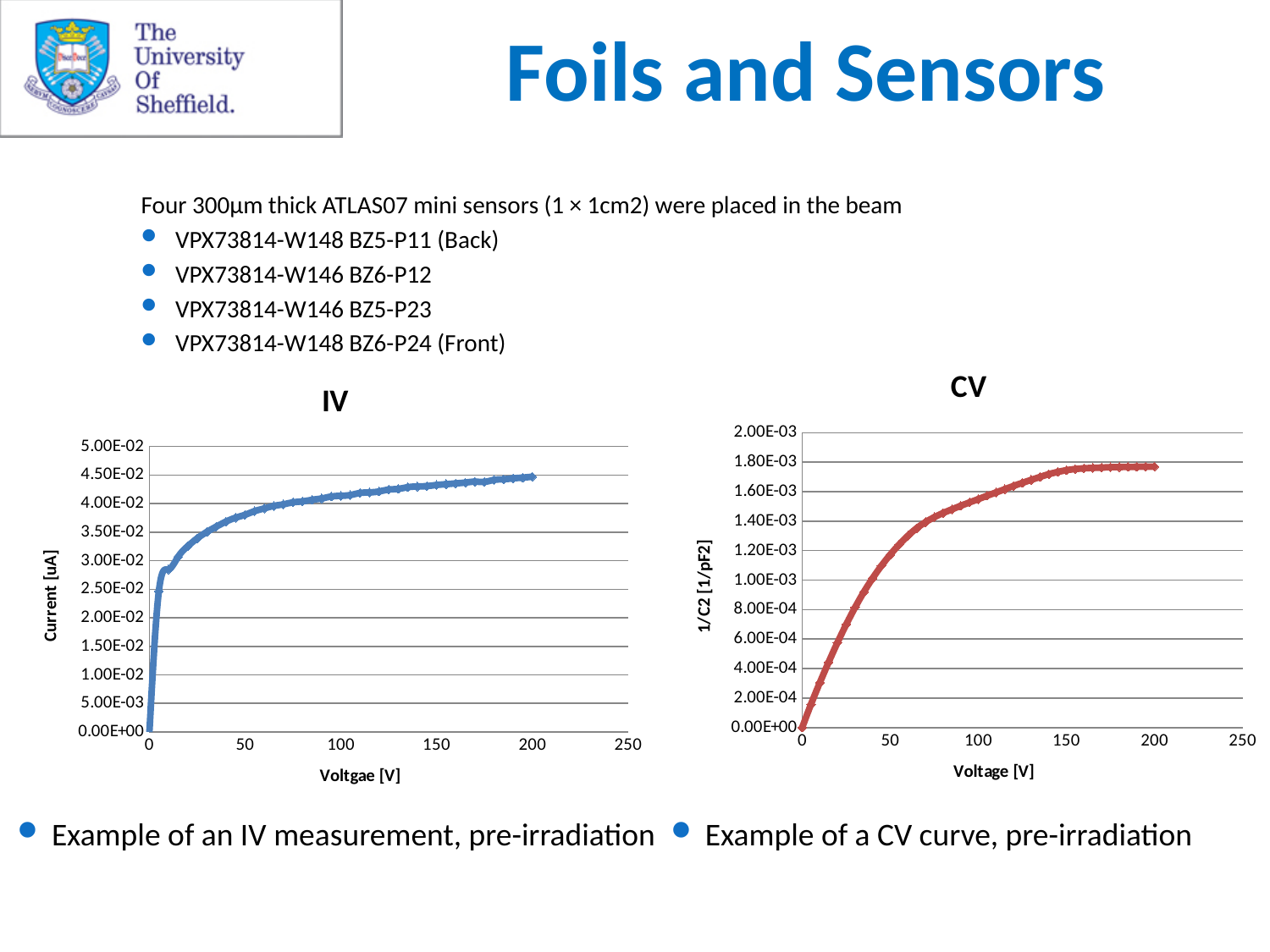
What kind of chart is the IV chart? line chart What is the y-axis label of the CV chart? 1/C2 [1/pF2] In the IV chart, is the current at 100 V greater or less than 3.50E-02? greater In the CV chart, is the value at 100 V greater or less than 1.40E-03? greater In the CV chart, is the value at 200 V greater or less than 1.60E-03? greater In the CV chart, does 1/C2 rise or fall as voltage increases from 0 to 200 V? rise What kind of chart is the CV chart? line chart What is the y-axis label of the IV chart? Current [uA] In the IV chart, does the current rise or fall as voltage increases from 0 to 200 V? rise